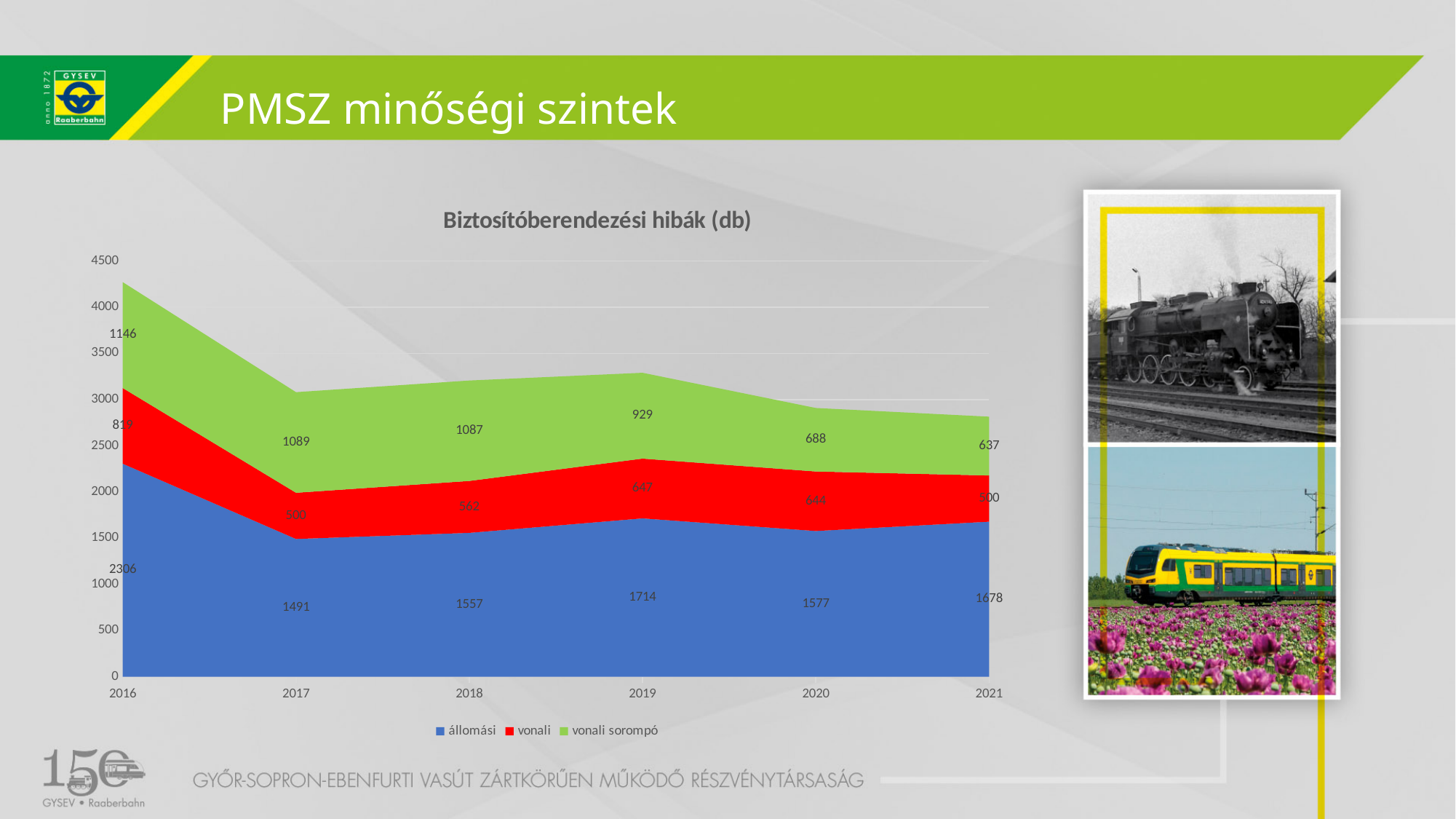
In which year is the vonali sorompó value lowest? 2021 How many years are shown on the x axis? 6 What is the difference between the állomási values in 2016 and 2017? 815 What kind of chart is shown? Stacked area chart In which year is the állomási value highest? 2016 What is the value for vonali sorompó in 2016? 1146 What is the total of all three series in 2021? 2815 Which is larger, the vonali value in 2019 or in 2020? 2019 What is the value for vonali in 2018? 562 What is the value for állomási in 2019? 1714 How many series does the legend list? 3 What is the title of the chart? Biztosítóberendezési hibák (db)